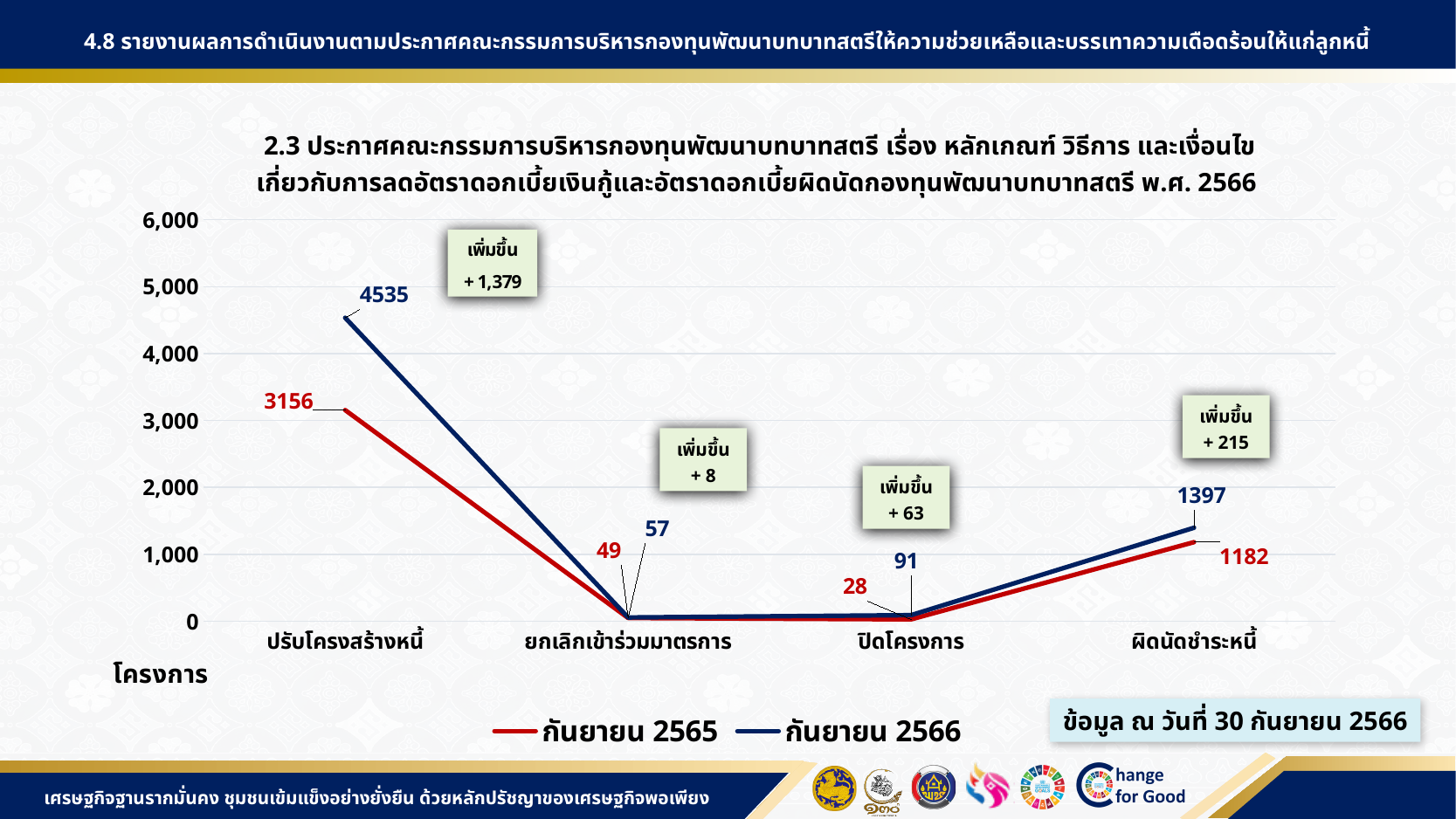
Which category has the highest value in the กันยายน 2566 series? ปรับโครงสร้างหนี้ What is the value for ผิดนัดชำระหนี้ in the กันยายน 2565 series? 1182 What is the difference between the กันยายน 2566 and กันยายน 2565 values for ผิดนัดชำระหนี้? 215 Which category has the lowest value in the กันยายน 2565 series? ปิดโครงการ Which colour is used for the กันยายน 2565 series? red What type of chart is shown on the slide? line chart Which series has the larger value for ยกเลิกเข้าร่วมมาตรการ, กันยายน 2565 or กันยายน 2566? กันยายน 2566 What is the value for ปิดโครงการ in the กันยายน 2566 series? 91 What is the value for ปรับโครงสร้างหนี้ in the กันยายน 2565 series? 3156 How many categories are shown on the x axis? 4 What is the value for ปรับโครงสร้างหนี้ in the กันยายน 2566 series? 4535 How many series does the legend list? 2